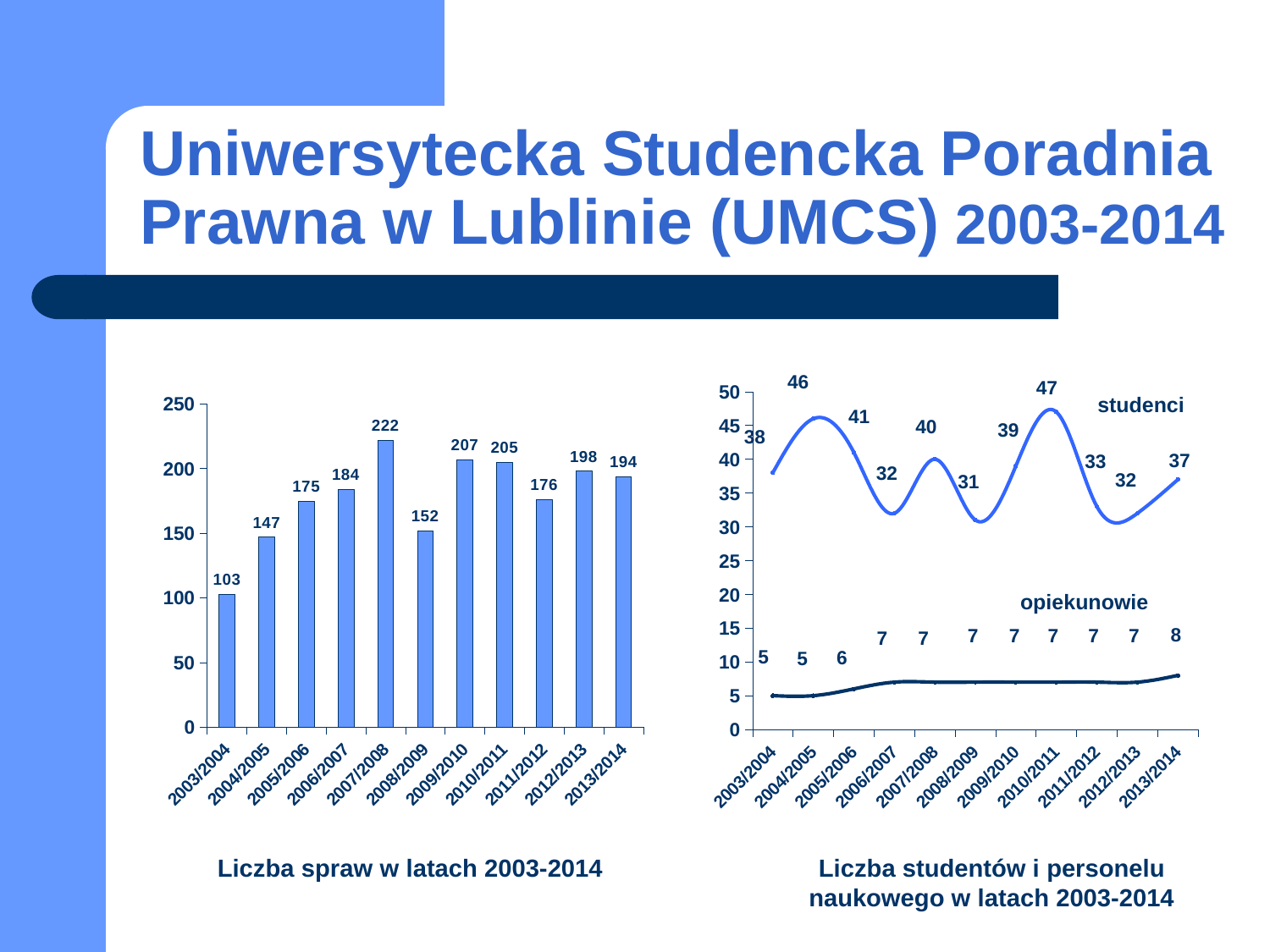
In the left chart (Liczba spraw w latach 2003-2014), how many years are shown on the x axis? 11 In the right chart (Liczba studentów i personelu naukowego w latach 2003-2014), how many series are plotted? 2 What kind of chart is the left chart (Liczba spraw w latach 2003-2014)? bar chart In the left chart (Liczba spraw w latach 2003-2014), which year has the highest value? 2007/2008 In the left chart (Liczba spraw w latach 2003-2014), what is the difference between the values for 2009/2010 and 2008/2009? 55 In the left chart (Liczba spraw w latach 2003-2014), which year has the lowest value? 2003/2004 In the right chart (Liczba studentów i personelu naukowego w latach 2003-2014), is the value for studenci in 2004/2005 larger than the value for studenci in 2005/2006? Yes In the right chart (Liczba studentów i personelu naukowego w latach 2003-2014), what is the value for studenci in 2010/2011? 47 In the left chart (Liczba spraw w latach 2003-2014), what is the value for 2007/2008? 222 In the right chart (Liczba studentów i personelu naukowego w latach 2003-2014), which year has the lowest value for studenci? 2008/2009 In the right chart (Liczba studentów i personelu naukowego w latach 2003-2014), what is the value for opiekunowie in 2013/2014? 8 What kind of chart is the right chart (Liczba studentów i personelu naukowego w latach 2003-2014)? line chart